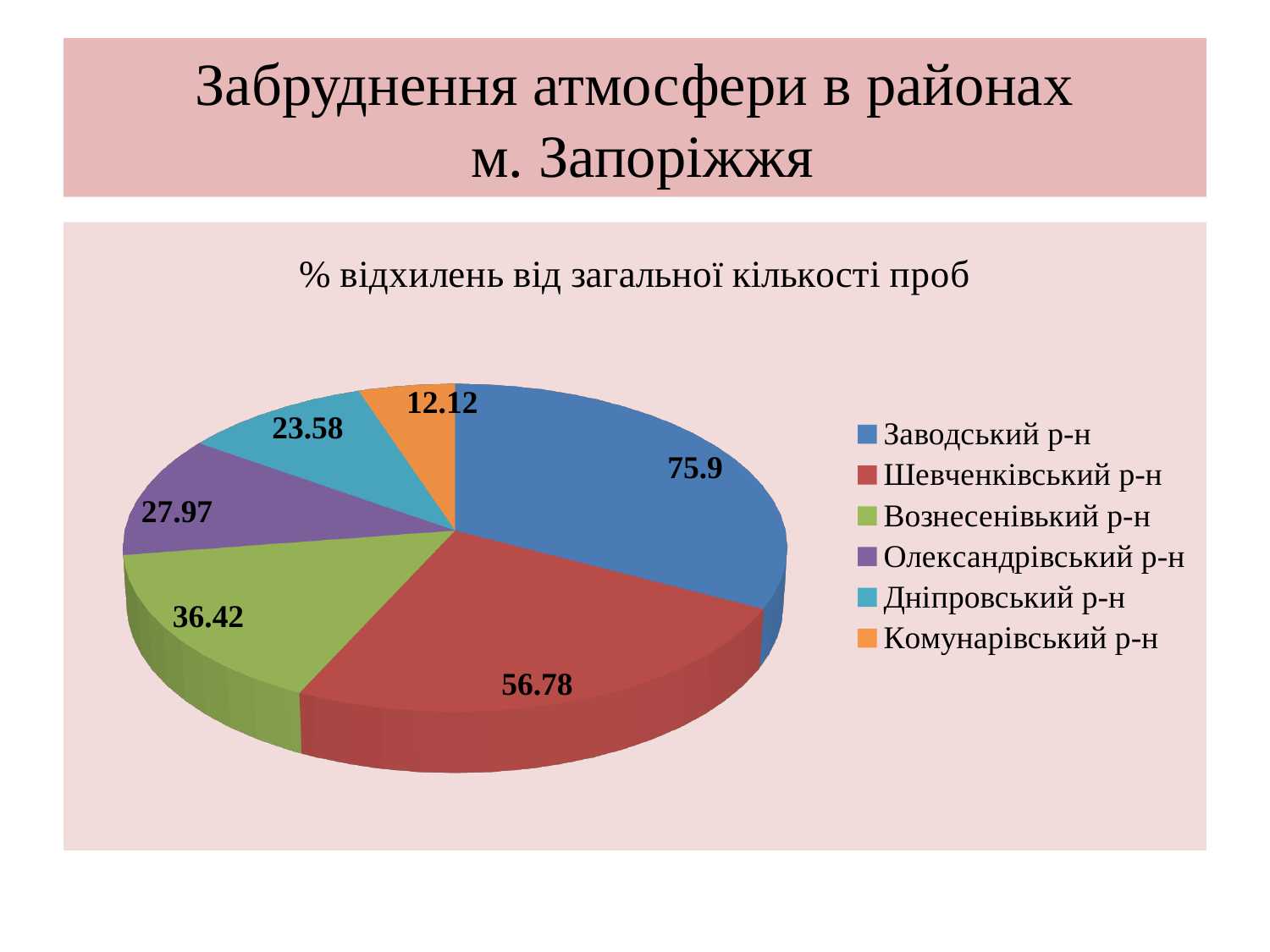
What type of chart is shown on the slide? Pie chart What is the difference between the values for Заводський р-н and Шевченківський р-н? 19.12 What is the value for Заводський р-н? 75.9 What is the value for Дніпровський р-н? 23.58 How many entries does the legend list? 6 How many slices does the pie chart have? 6 What is the value for Шевченківський р-н? 56.78 What is the title of the chart? % відхилень від загальної кількості проб What is the value for Вознесенівький р-н? 36.42 What is the value for Олександрівський р-н? 27.97 Which district has the lowest value? Комунарівський р-н Which district has the highest value? Заводський р-н